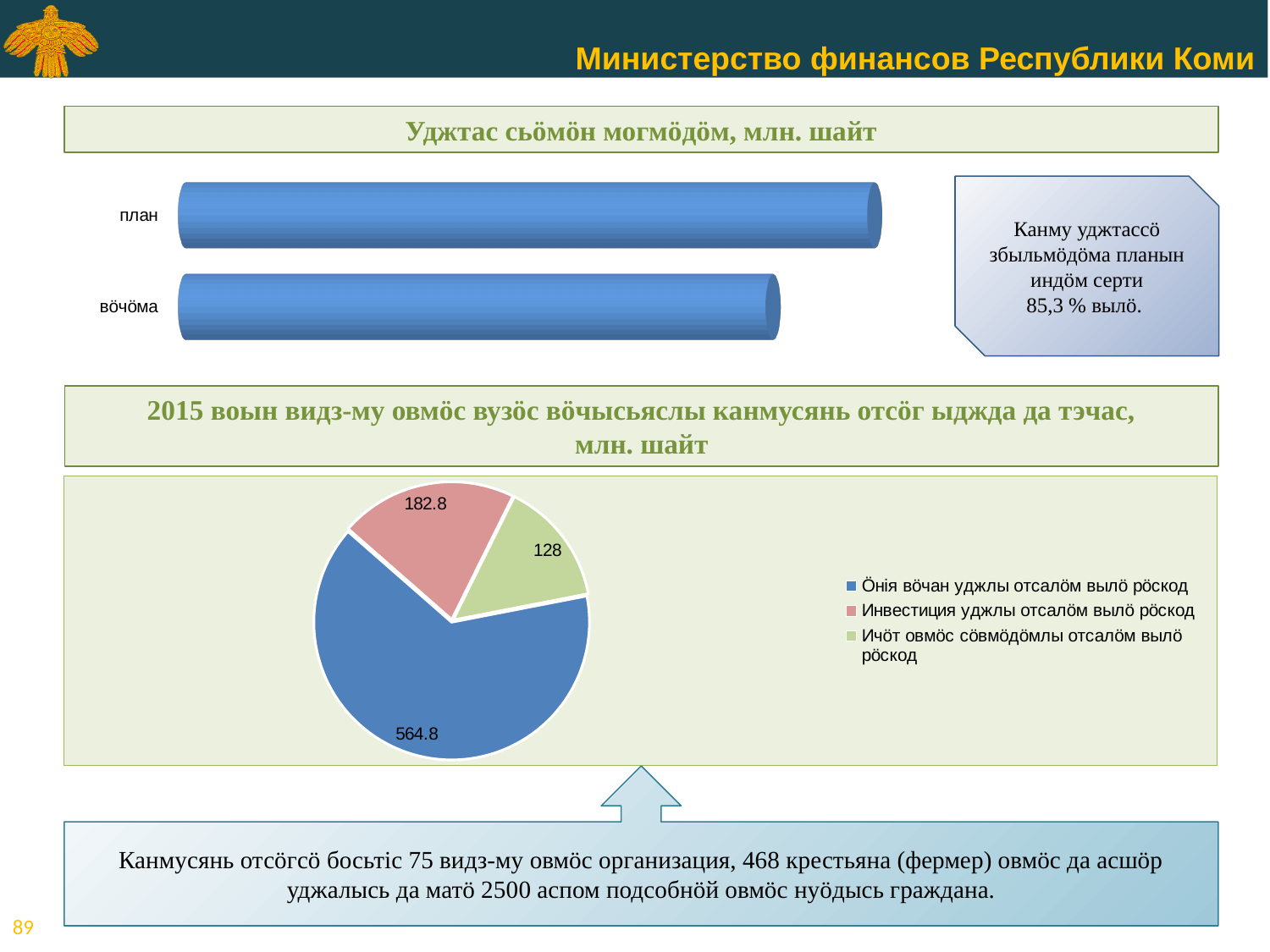
In the pie chart at the bottom of the slide, which category has the largest slice? Öнія вöчан уджлы отсалöм вылö рöскод What kind of chart is shown under the title 'Уджтас сьöмöн могмöдöм, млн. шайт'? Bar chart In the pie chart at the bottom of the slide, what is the total of all three slices? 875.6 In the pie chart at the bottom of the slide, what is the value for 'Ичöт овмöс сöвмöдöмлы отсалöм вылö рöскод'? 128 What kind of chart is shown at the bottom of the slide? Pie chart In the pie chart at the bottom of the slide, what is the value for 'Инвестиция уджлы отсалöм вылö рöскод'? 182.8 How many entries does the legend of the pie chart at the bottom of the slide list? 3 In the pie chart at the bottom of the slide, what is the difference between the values 564.8 and 182.8? 382 In the pie chart at the bottom of the slide, what is the value for 'Öнія вöчан уджлы отсалöм вылö рöскод'? 564.8 In the pie chart at the bottom of the slide, which category has the smallest slice? Ичöт овмöс сöвмöдöмлы отсалöм вылö рöскод In the bar chart under 'Уджтас сьöмöн могмöдöм, млн. шайт', which bar is longer, 'план' or 'вöчöма'? план How many bars are shown in the bar chart under 'Уджтас сьöмöн могмöдöм, млн. шайт'? 2